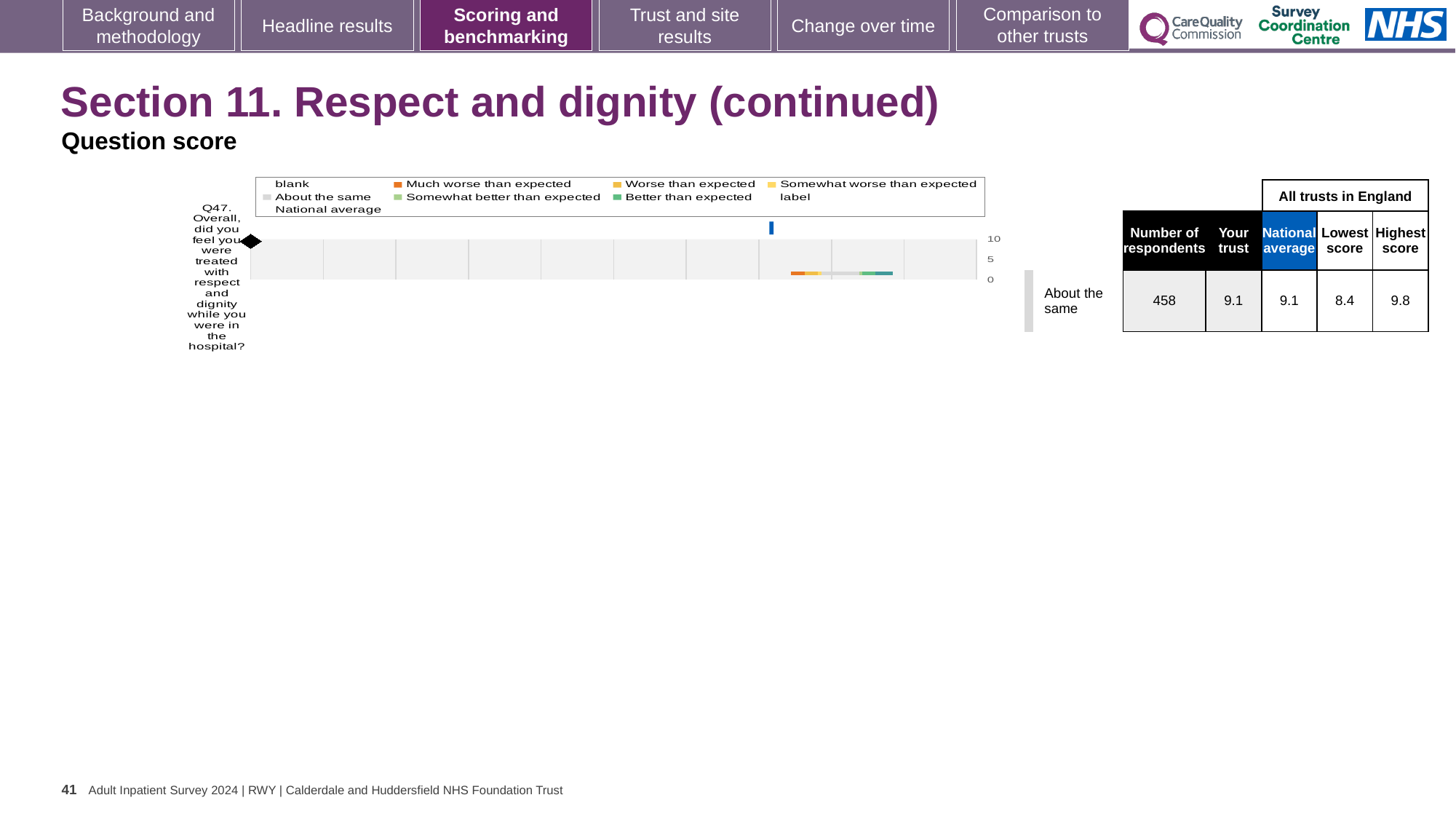
What is the 'Your trust' score for Q47 (treated with respect and dignity)? 9.1 How is the trust's result for Q47 categorised relative to other trusts? About the same Is the trust's score for Q47 greater or less than 5? greater What is the national average score for Q47? 9.1 What is the highest score among all trusts in England for Q47? 9.8 What is the difference between the highest and lowest scores for Q47 across all trusts in England? 1.4 Is the trust's score for Q47 larger than, smaller than, or equal to the national average? equal What is the maximum value shown on the chart's axis? 10 How many respondents answered Q47? 458 What is the lowest score among all trusts in England for Q47? 8.4 What kind of chart is shown on the slide? bar chart How many questions are plotted on the chart? 1